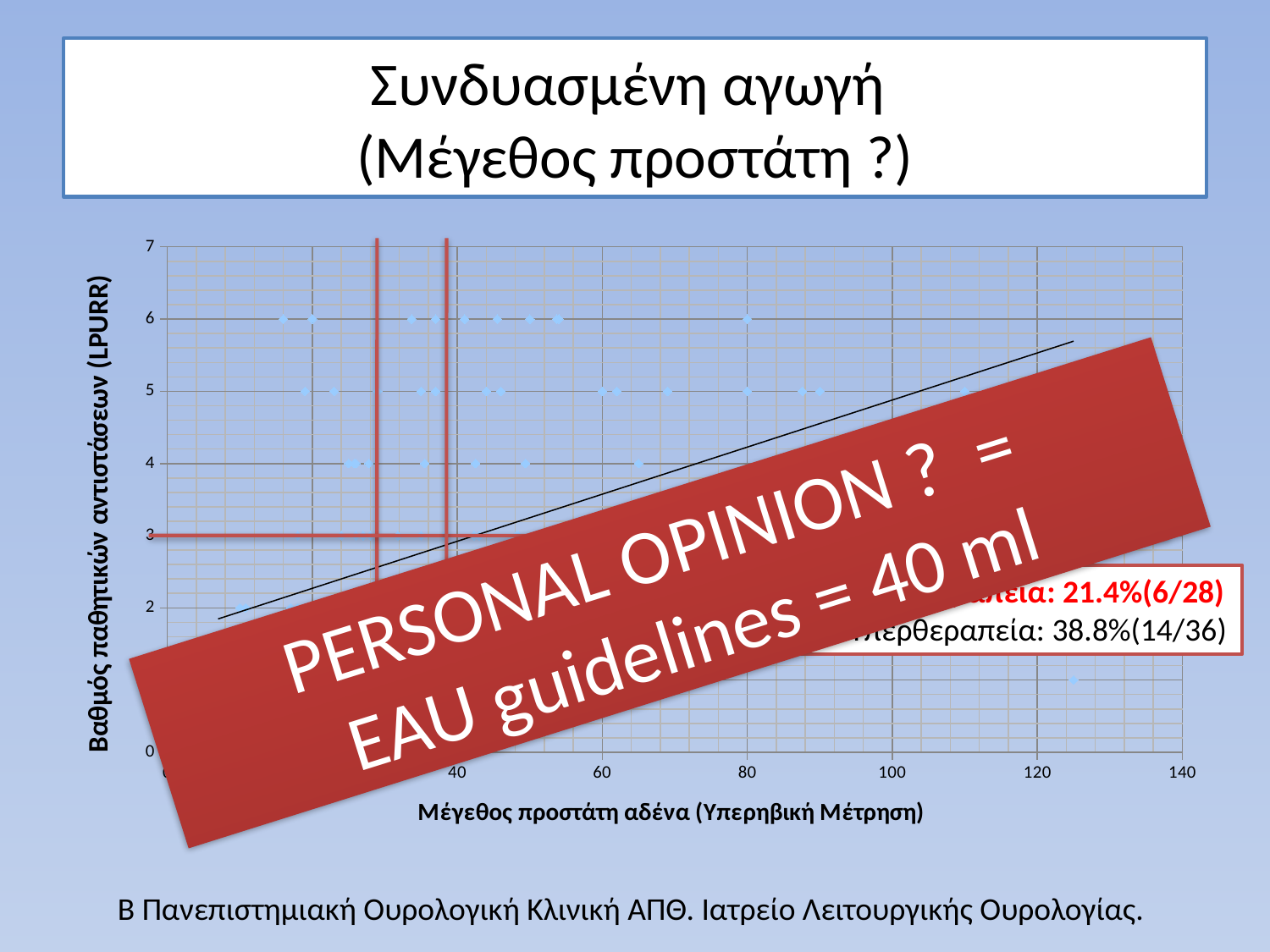
Is the prostate size of the rightmost plotted point greater or less than 120? greater Does the fitted straight line in the chart rise or fall as prostate size increases along the x axis? rises What is the highest tick value shown on the vertical axis? 7 What kind of chart is shown on the slide? scatter chart What is the highest LPURR value at which any data point is plotted? 6 Are any data points plotted at an LPURR value of 7? No What is the label of the vertical axis of the chart? Βαθμός παθητικών αντιστάσεων (LPURR) What is the highest tick value shown on the horizontal axis? 140 What is the label of the horizontal axis of the chart? Μέγεθος προστάτη αδένα (Υπερηβική Μέτρηση)